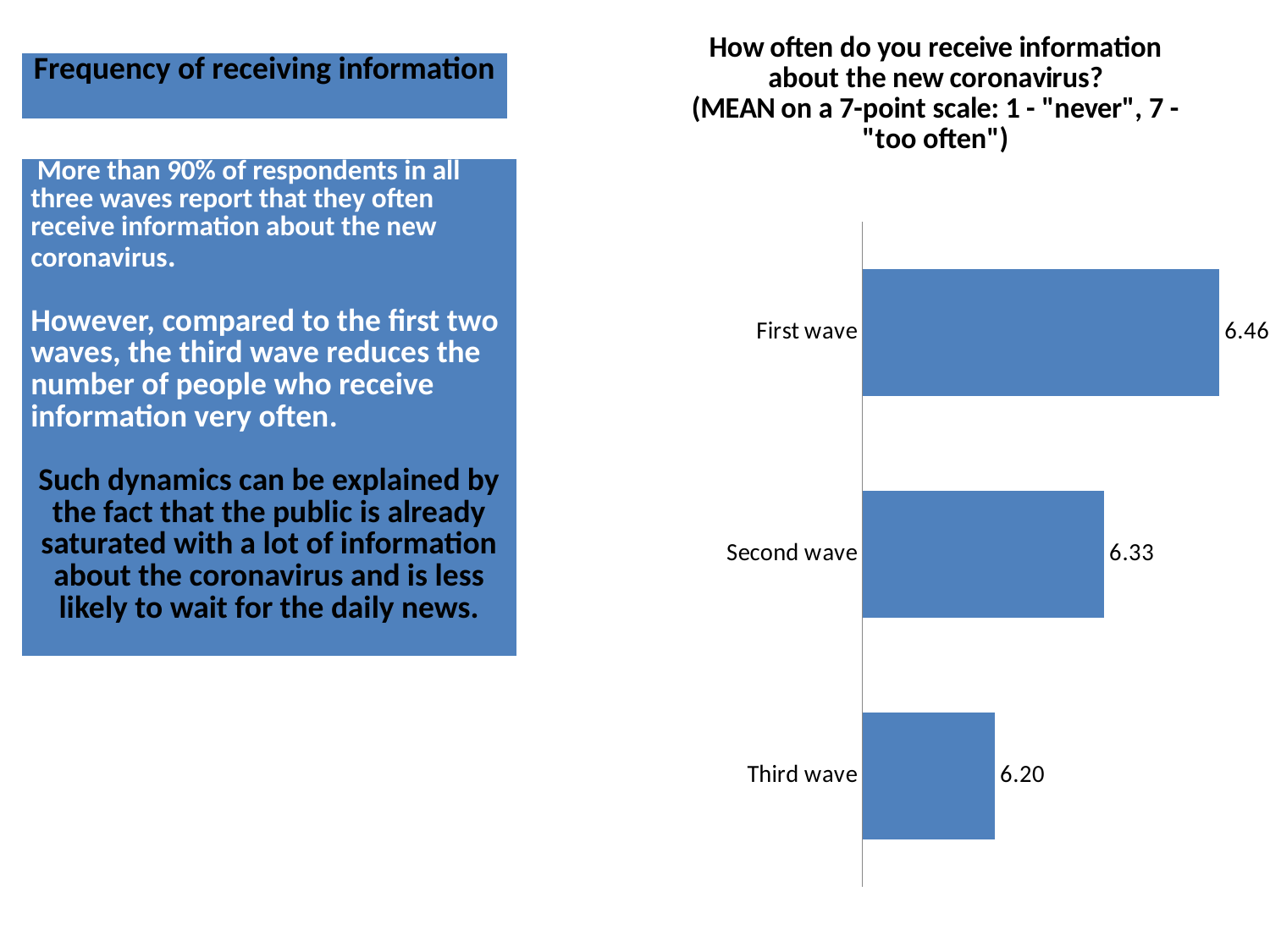
What scale is the mean measured on, according to the chart title? 7-point scale What kind of chart is shown on the slide? Bar chart What is the mean value for the First wave? 6.46 What is the difference between the First wave and Second wave values? 0.13 How many waves (categories) are shown in the chart? 3 Which is larger, the value for the Second wave or the Third wave? Second wave Do the values rise or fall from the First wave to the Third wave? Fall Which wave has the highest mean value? First wave Which wave has the lowest mean value? Third wave What is the mean value for the Third wave? 6.20 What is the difference between the First wave and Third wave values? 0.26 What is the mean value for the Second wave? 6.33